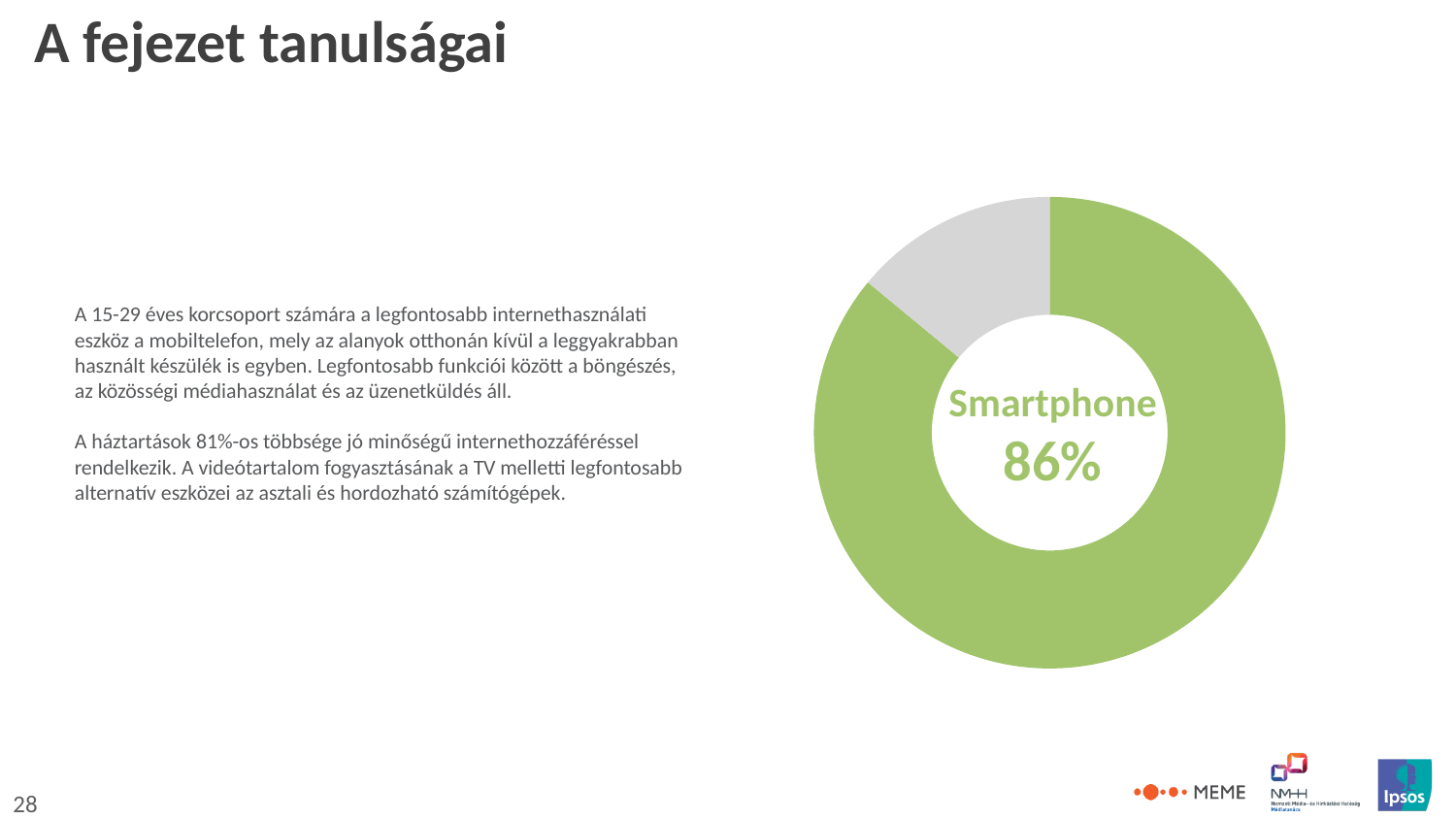
Which category is the largest in the donut chart? Smartphone What kind of chart is shown on the slide? Donut (pie) chart Which slice of the donut chart is larger, the green one or the grey one? The green one (Smartphone) What label is printed in the centre of the donut chart? Smartphone 86% What share of the donut chart does the Smartphone slice represent? 86% How many slices does the donut chart have? 2 What colour is the Smartphone slice in the donut chart? Green What value is shown for Smartphone in the donut chart? 86% Is the Smartphone share in the donut chart greater or less than 50%? greater